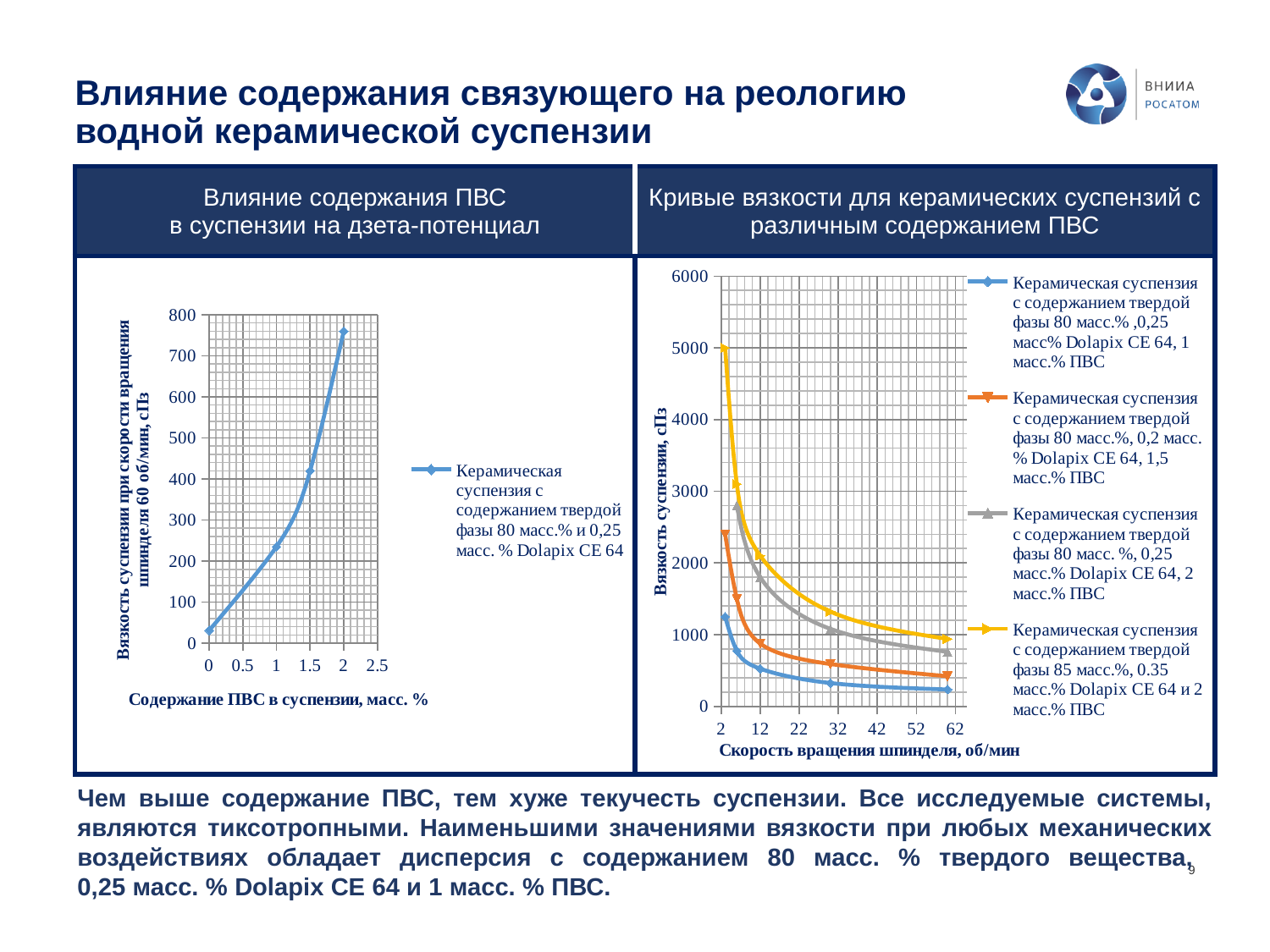
On the right chart, is the viscosity of the series with 1,5 масс.% ПВС at 2 об/мин greater or less than 3000? less On the left chart, does the viscosity rise or fall as the PVA content increases along the x axis? rises What is the x-axis label of the right chart? Скорость вращения шпинделя, об/мин How many data points are plotted on the left chart? 4 On the right chart, does the viscosity rise or fall as the spindle speed increases along the x axis? falls On the left chart, is the viscosity at 1 масс. % ПВС greater or less than 300? less On the right chart, is the viscosity of the 85 масс.% series at 2 об/мин greater or less than 4000? greater How many series does the legend of the right chart, 'Кривые вязкости для керамических суспензий с различным содержанием ПВС', list? 4 On the right chart, which series has the highest viscosity at a spindle speed of 2 об/мин? Керамическая суспензия с содержанием твердой фазы 85 масс.%, 0.35 масс.% Dolapix CE 64 и 2 масс.% ПВС What kind of chart is the left chart, 'Влияние содержания ПВС в суспензии на дзета-потенциал'? line chart On the right chart, which series has the lowest viscosity across the spindle speeds? Керамическая суспензия с содержанием твердой фазы 80 масс.%, 0,25 масс% Dolapix CE 64, 1 масс.% ПВС